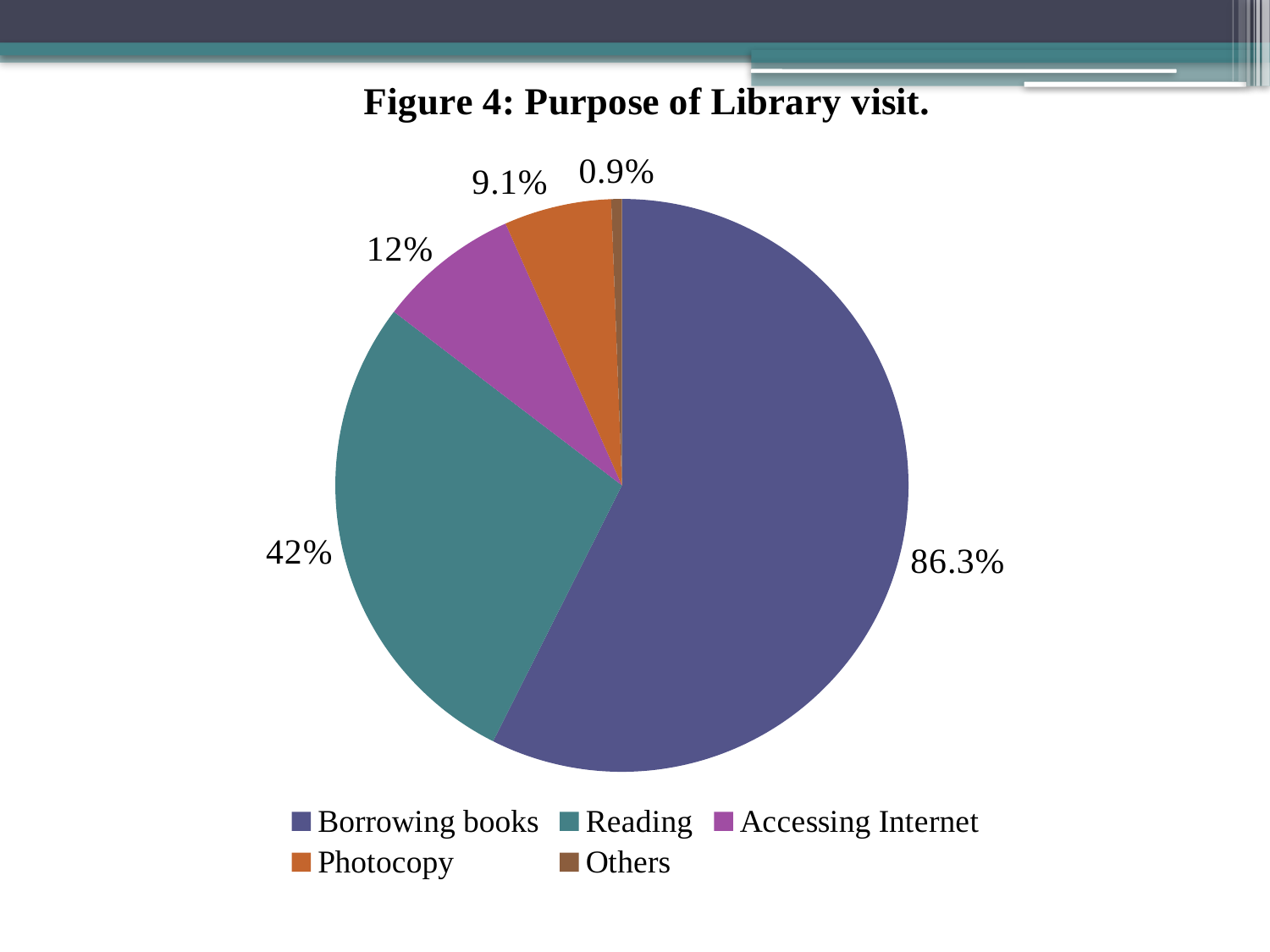
Which purpose of library visit has the smallest slice? Others What value is labelled for Photocopy? 9.1% What value is labelled for Accessing Internet? 12% Which purpose of library visit has the largest slice? Borrowing books What value is labelled for Reading? 42% What is the difference between the labelled values for Borrowing books and Reading? 44.3% How many categories does the legend list? 5 What kind of chart is shown on the slide? pie chart What value is labelled for Others? 0.9% Which is larger, the value for Accessing Internet or the value for Photocopy? Accessing Internet What value is labelled for Borrowing books? 86.3% What is the title of the chart? Figure 4: Purpose of Library visit.